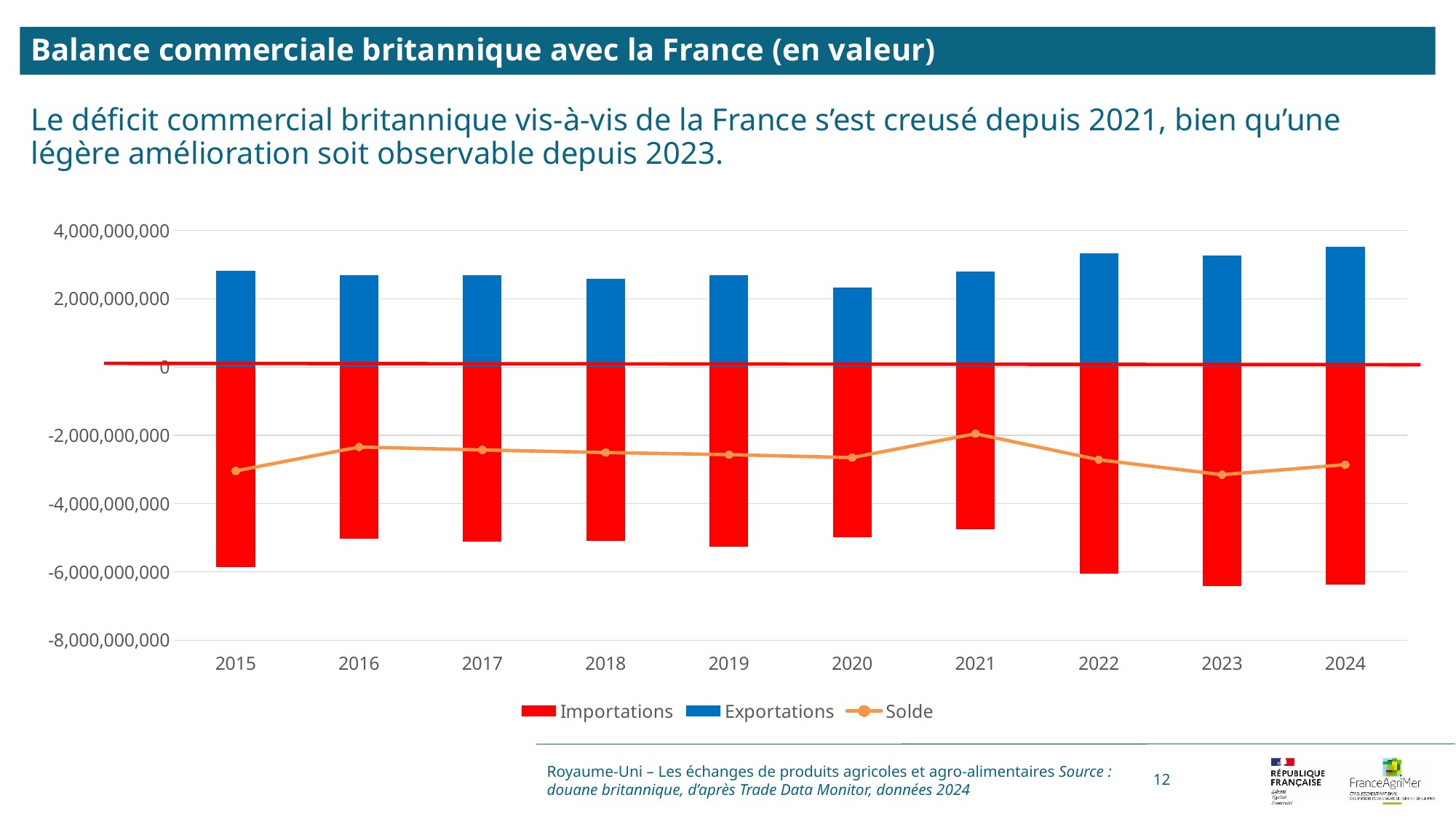
What kind of chart is shown on the slide? bar chart with a line Is the value of Exportations in 2024 greater or less than 2,000,000,000? greater How many years are shown on the x axis of the chart? 10 How many series does the chart legend list? 3 Does the Solde line rise or fall from 2021 to 2023? fall Is the value of Importations in 2023 greater or less than -6,000,000,000? less In which year is the Solde line at its highest point? 2021 In which year are Exportations lowest? 2020 In which year are Exportations highest? 2024 Is the Solde value in 2015 greater or less than -2,000,000,000? less Which year has the larger Exportations value, 2015 or 2022? 2022 What colour represents Importations in the chart? red